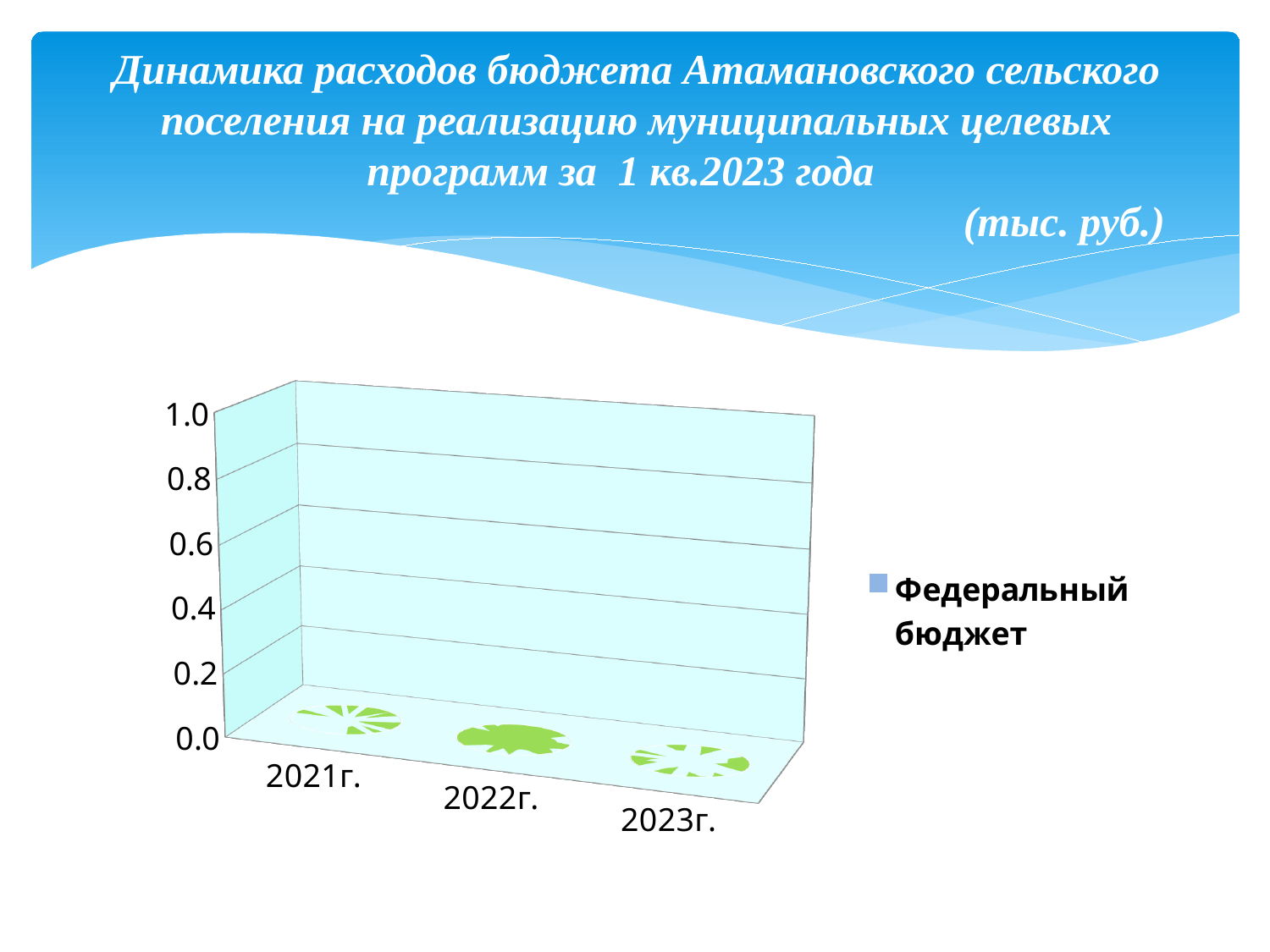
What is the highest tick value shown on the vertical axis of the chart? 1.0 Is the value for 2022г. greater or less than 0.2? less Is the value for 2022г. greater or less than 0.6? less How many series does the chart legend list? 1 How many categories are shown on the x axis of the chart? 3 What kind of chart is shown on the slide? bar chart Which years are shown as categories on the x axis of the chart? 2021г., 2022г., 2023г. Is the value for 2021г. greater or less than 0.2? less What is the name of the series listed in the chart legend? Федеральный бюджет